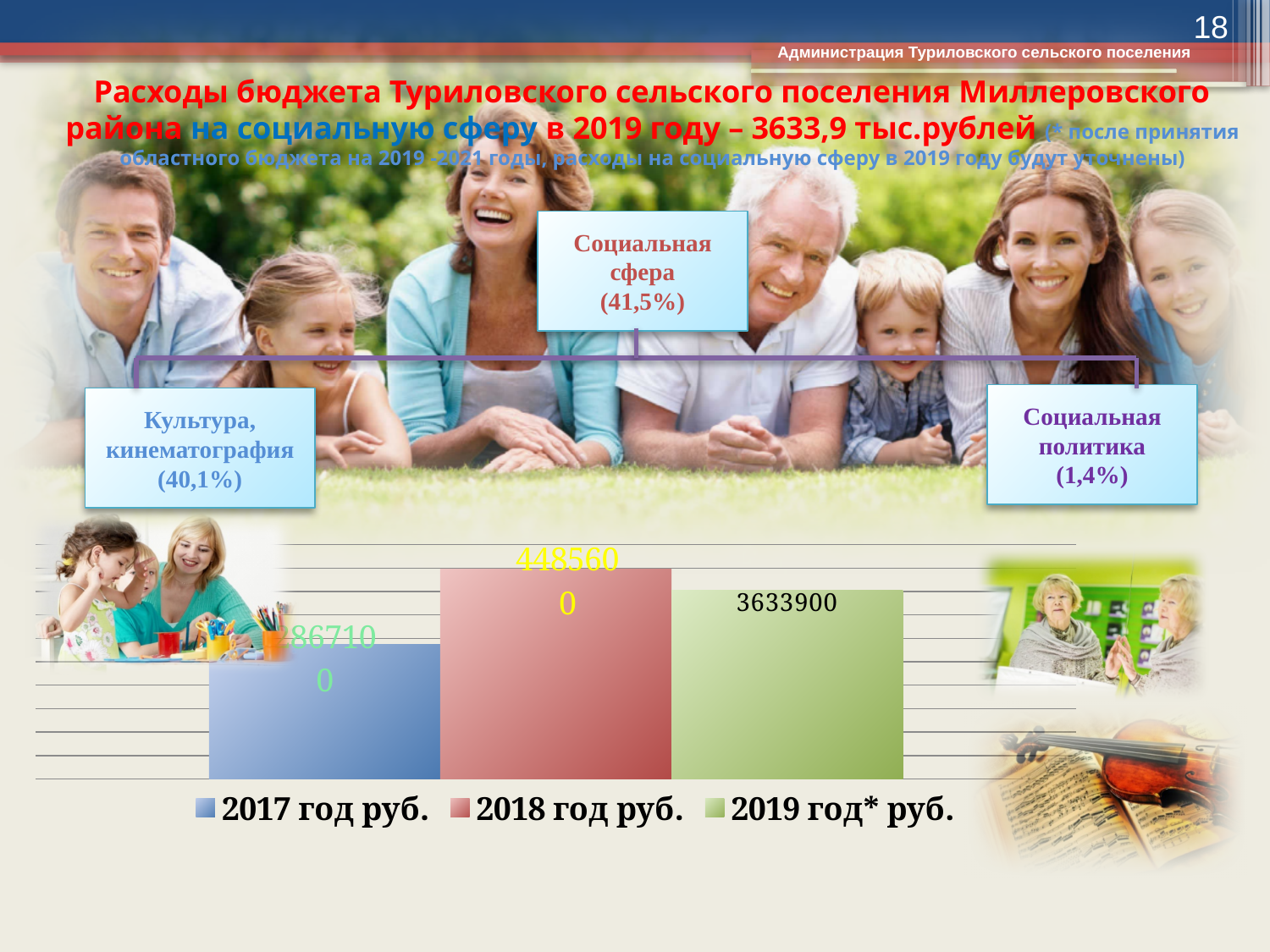
Which is larger, the value for 2018 год руб. or for 2019 год* руб.? 2018 год руб. How many bars are plotted in the chart? 3 Do the bar values rise or fall from 2018 to 2019? fall What is the legend entry for the red bar? 2018 год руб. What kind of chart is shown on the slide? bar chart What is the value shown for 2019 год* руб.? 3633900 Which year has the lowest bar in the chart? 2017 год руб. How many series does the chart legend list? 3 What is the value shown for 2018 год руб.? 4485600 What colour is the bar for 2019 год* руб.? green Which year has the highest bar in the chart? 2018 год руб. What is the difference between the values for 2018 год руб. and 2019 год* руб.? 851700